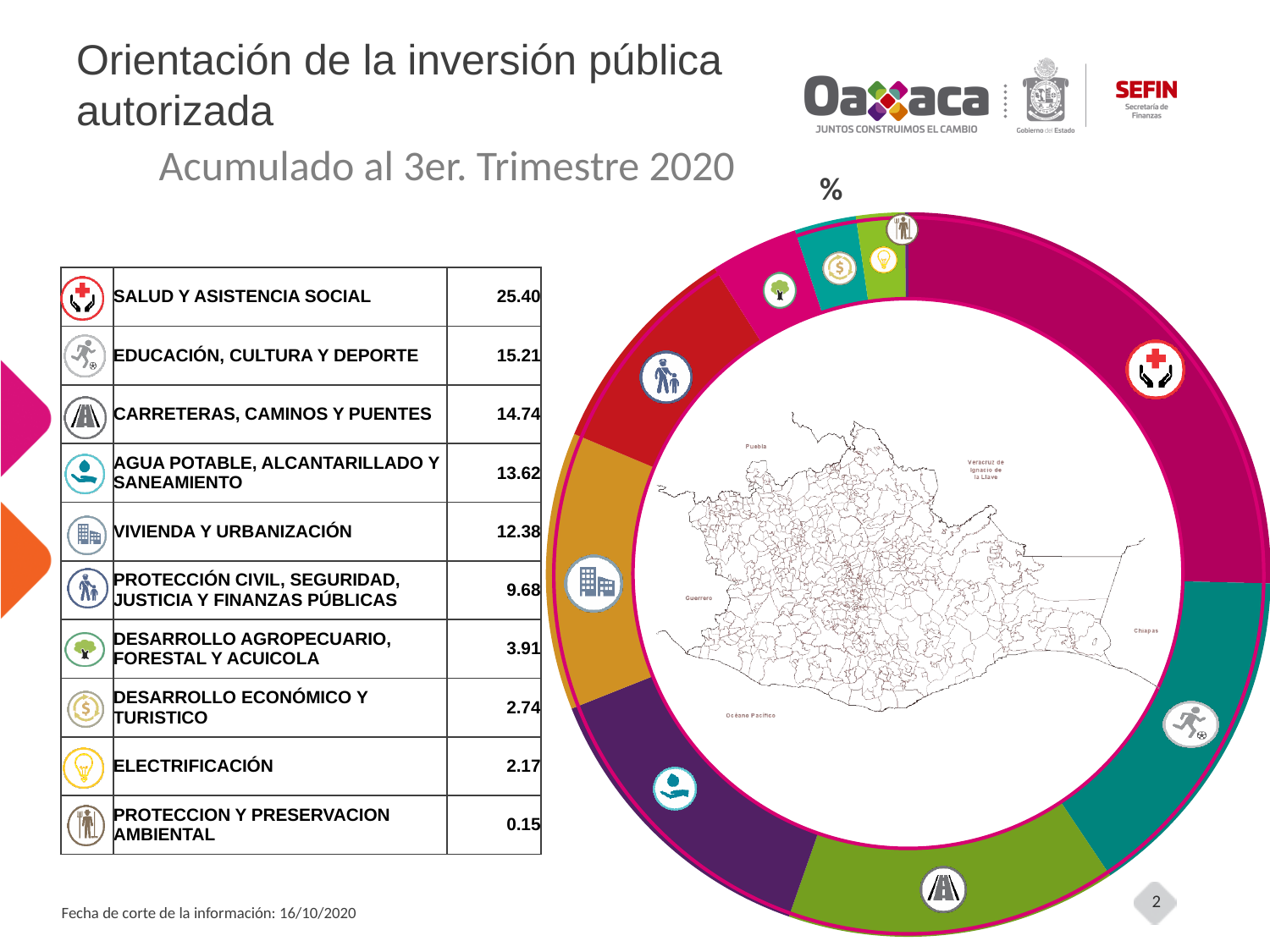
Which category has the highest value? SALUD Y ASISTENCIA SOCIAL What kind of chart is shown on the slide? Doughnut (pie) chart What is the value for VIVIENDA Y URBANIZACIÓN? 12.38 How many categories does the chart show? 10 What unit is indicated above the chart? % Which category has the lowest value? PROTECCION Y PRESERVACION AMBIENTAL What share of the chart does SALUD Y ASISTENCIA SOCIAL represent? 25.40% What is the value for DESARROLLO AGROPECUARIO, FORESTAL Y ACUICOLA? 3.91 What is the difference between SALUD Y ASISTENCIA SOCIAL and EDUCACIÓN, CULTURA Y DEPORTE? 10.19 What is the value for SALUD Y ASISTENCIA SOCIAL? 25.40 What is the value for ELECTRIFICACIÓN? 2.17 Which is larger, CARRETERAS, CAMINOS Y PUENTES or AGUA POTABLE, ALCANTARILLADO Y SANEAMIENTO? CARRETERAS, CAMINOS Y PUENTES